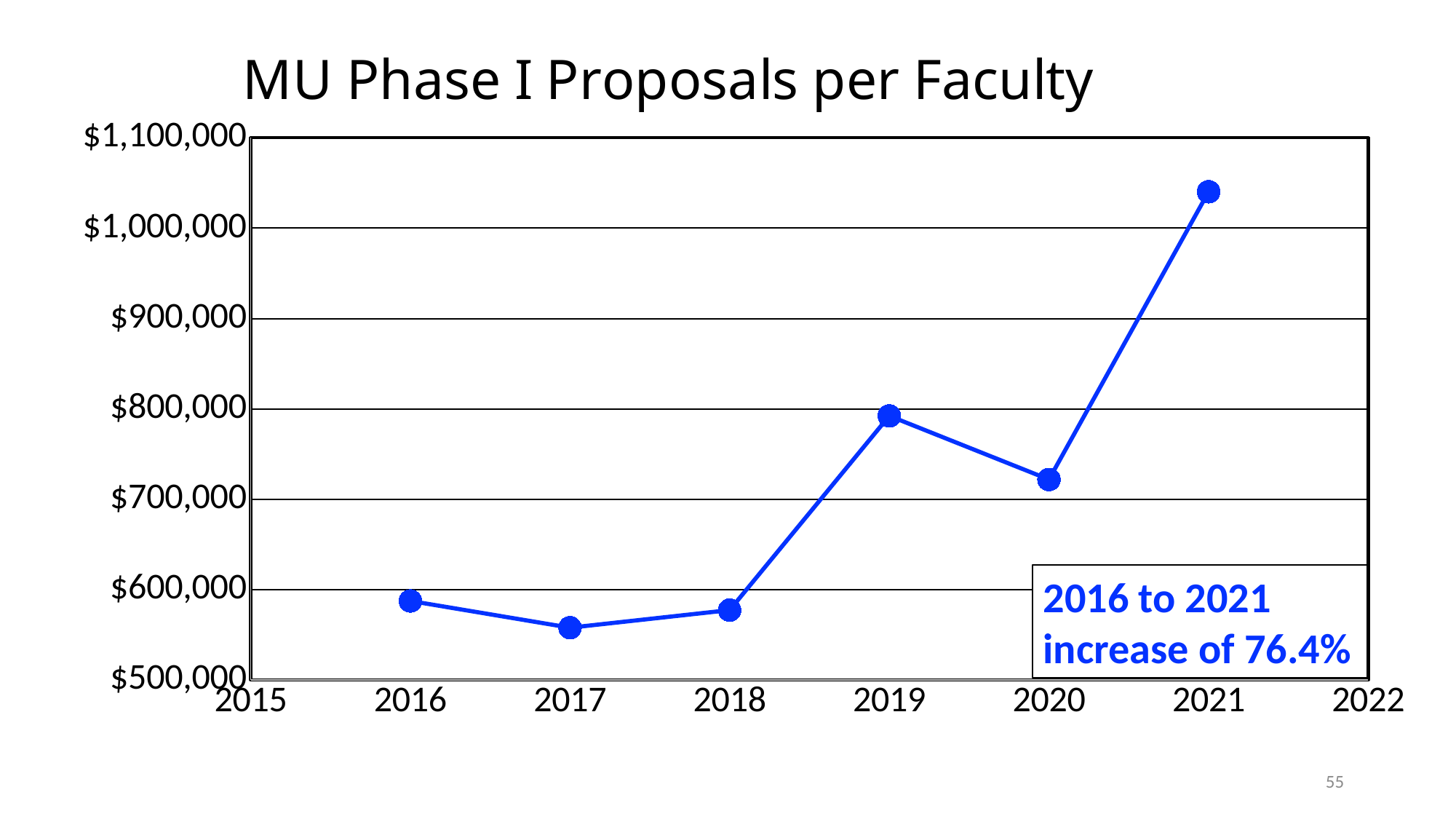
How many data points are plotted on the line? 6 Which year has the larger value, 2019 or 2020? 2019 Is the value for 2017 greater or less than $600,000? less Which year has the lowest value? 2017 According to the text box on the chart, what is the percentage increase from 2016 to 2021? 76.4% What kind of chart is shown on the slide? line chart What is the title of the chart? MU Phase I Proposals per Faculty Is the value for 2020 greater or less than $700,000? greater Is the value for 2021 greater or less than $1,000,000? greater Does the value rise or fall from 2018 to 2019? rise Which year has the highest value? 2021